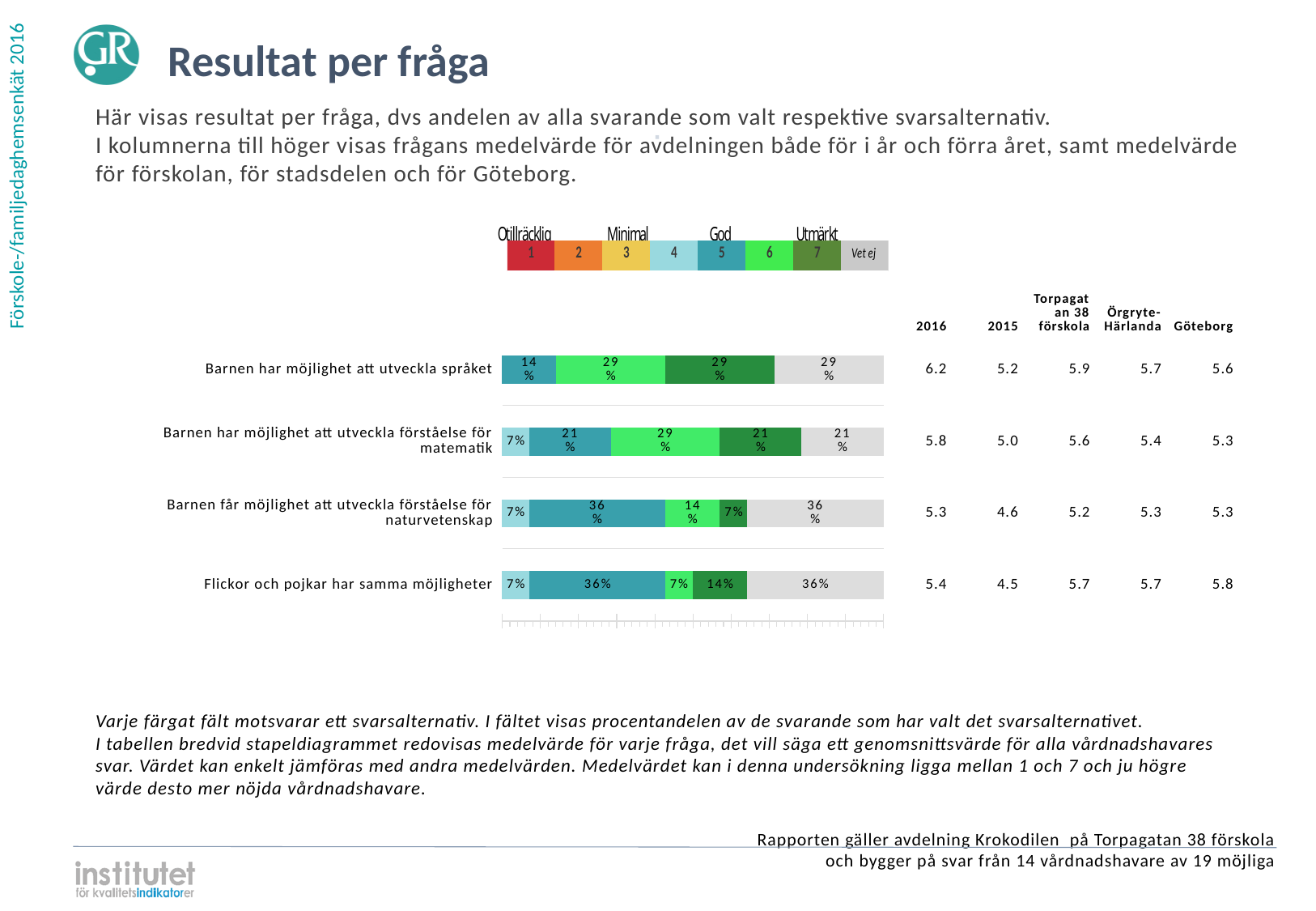
For 'Flickor och pojkar har samma möjligheter', which is larger: the share for option 5 or the share for option 7? Option 5 (36%) What kind of chart is used to show the results per question? Stacked bar chart Which question has the smallest 'Vet ej' share? Barnen har möjlighet att utveckla förståelse för matematik What is the 2016 mean value for 'Barnen har möjlighet att utveckla språket' in the table next to the chart? 6.2 What percentage chose answer option 6 (light green) for 'Barnen har möjlighet att utveckla förståelse för matematik'? 29% How many questions (categories) are shown in the bar chart? 4 What percentage chose answer option 7 (dark green) for 'Flickor och pojkar har samma möjligheter'? 14% What is the difference in percentage points between the 'Vet ej' share for 'Barnen får möjlighet att utveckla förståelse för naturvetenskap' (36%) and for 'Barnen har möjlighet att utveckla språket' (29%)? 7 percentage points How many entries does the legend above the chart list? 8 What percentage chose answer option 5 (teal) for 'Barnen får möjlighet att utveckla förståelse för naturvetenskap'? 36% What percentage of respondents chose 'Vet ej' for 'Barnen har möjlighet att utveckla språket'? 29%